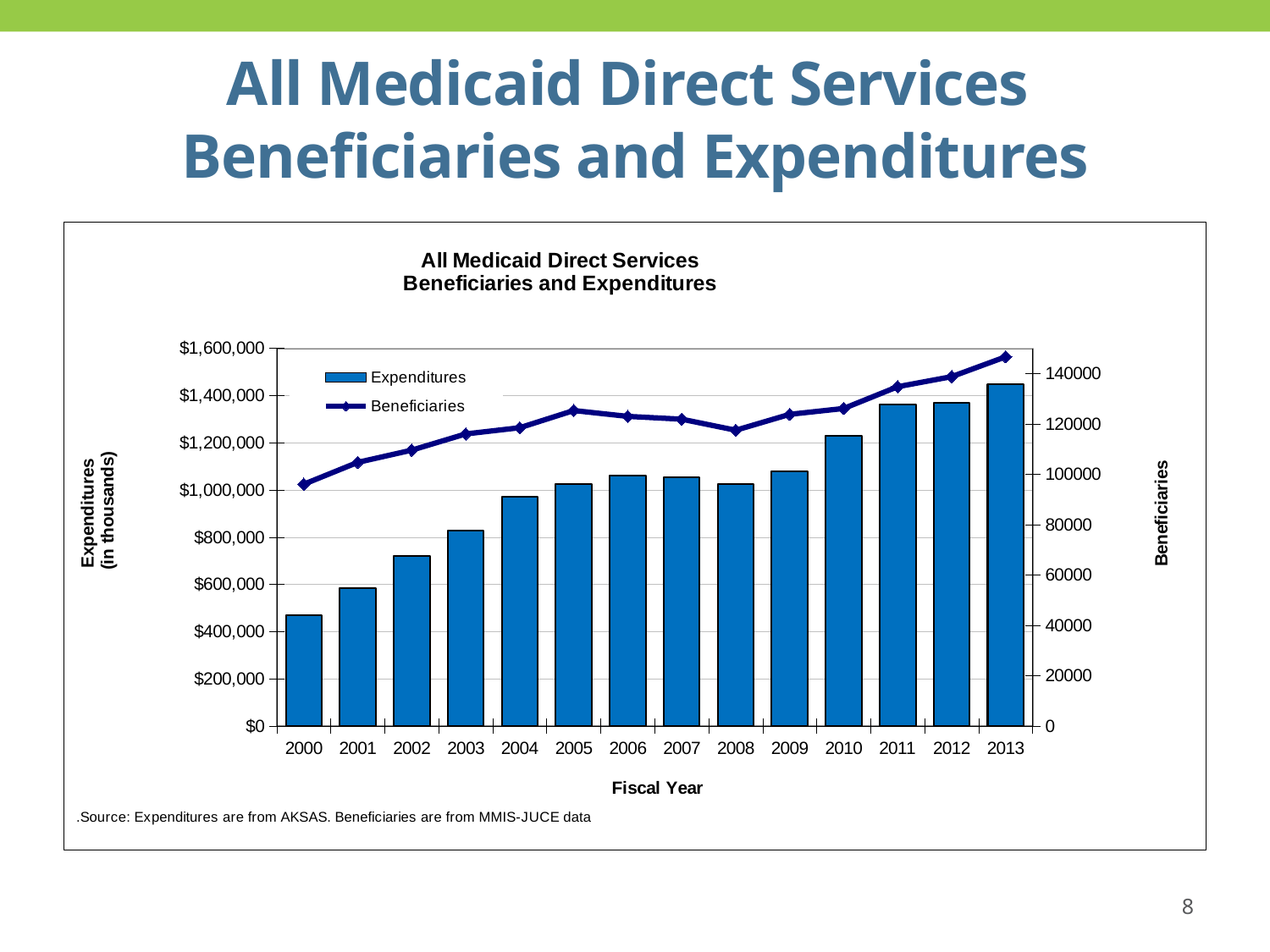
In which fiscal year does the Beneficiaries line reach its highest point? 2013 Is the Beneficiaries value for 2008 greater or less than 120000? less Which fiscal year has the lowest Expenditures bar? 2000 Is the Expenditures value for 2000 greater or less than $600,000? less Which fiscal year has the highest Expenditures bar? 2013 Do Expenditures generally rise or fall from 2000 to 2013? rise How many series does the chart legend list? 2 Which fiscal year has the larger Expenditures bar, 2002 or 2003? 2003 Is the Expenditures value for 2011 greater or less than $1,200,000? greater What kind of chart is shown on the slide? A bar chart combined with a line How many fiscal years are shown on the x axis of the chart? 14